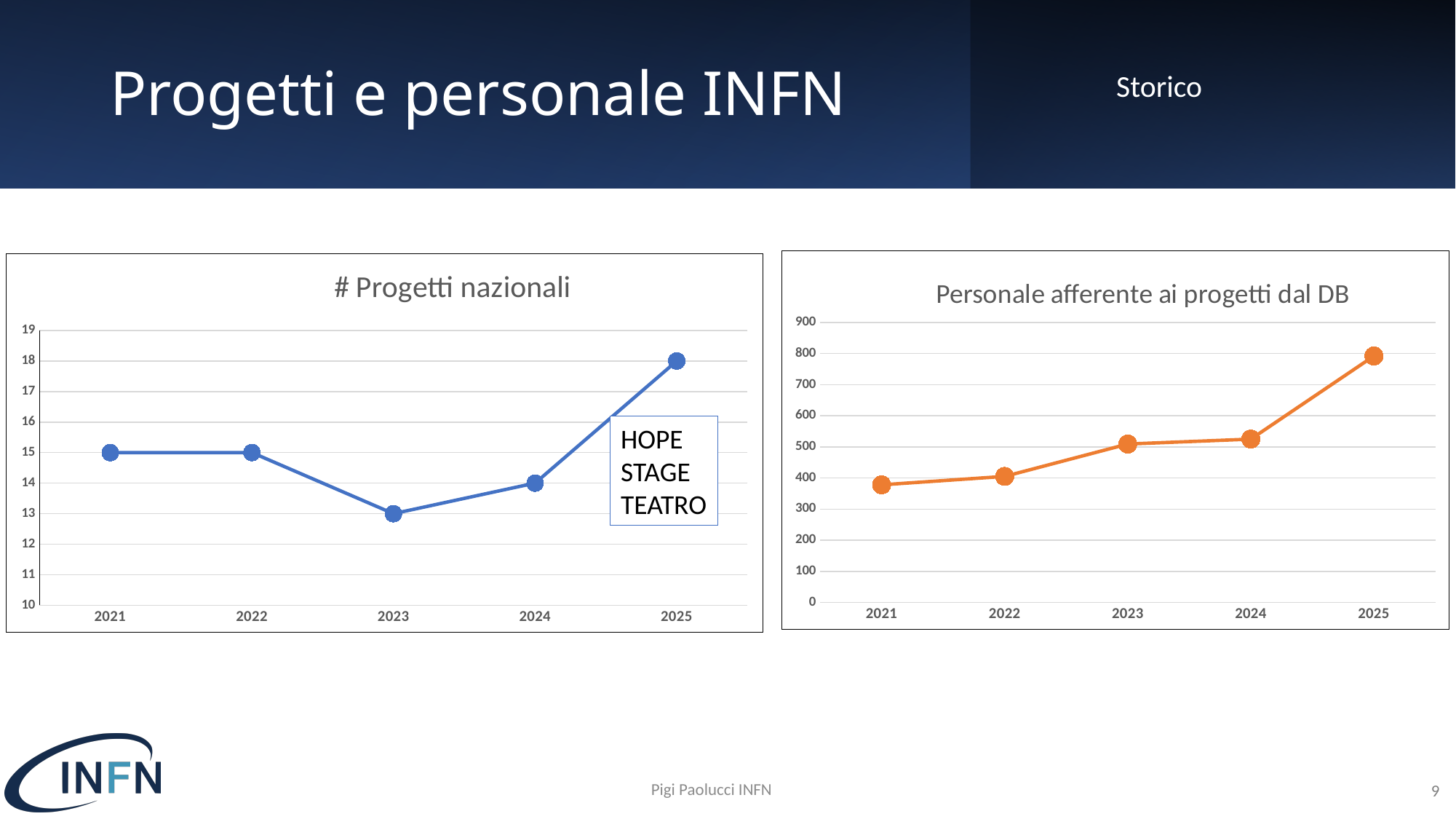
In the 'Personale afferente ai progetti dal DB' chart, is the value for 2025 greater or less than 700? greater In the 'Personale afferente ai progetti dal DB' chart, which year has the highest value? 2025 In the '# Progetti nazionali' chart, what is the value for 2023? 13 In the '# Progetti nazionali' chart, how many data points are plotted? 5 In the 'Personale afferente ai progetti dal DB' chart, is the value for 2021 greater or less than 400? less What kind of chart is the 'Personale afferente ai progetti dal DB' chart? line chart In the '# Progetti nazionali' chart, what is the difference between the values for 2025 and 2024? 4 In the 'Personale afferente ai progetti dal DB' chart, do the values rise or fall from 2021 to 2025? rise In the '# Progetti nazionali' chart, which year has the lowest value? 2023 In the 'Personale afferente ai progetti dal DB' chart, is the value for 2023 larger than the value for 2022? yes In the '# Progetti nazionali' chart, which year has the highest value? 2025 In the '# Progetti nazionali' chart, what is the value for 2025? 18